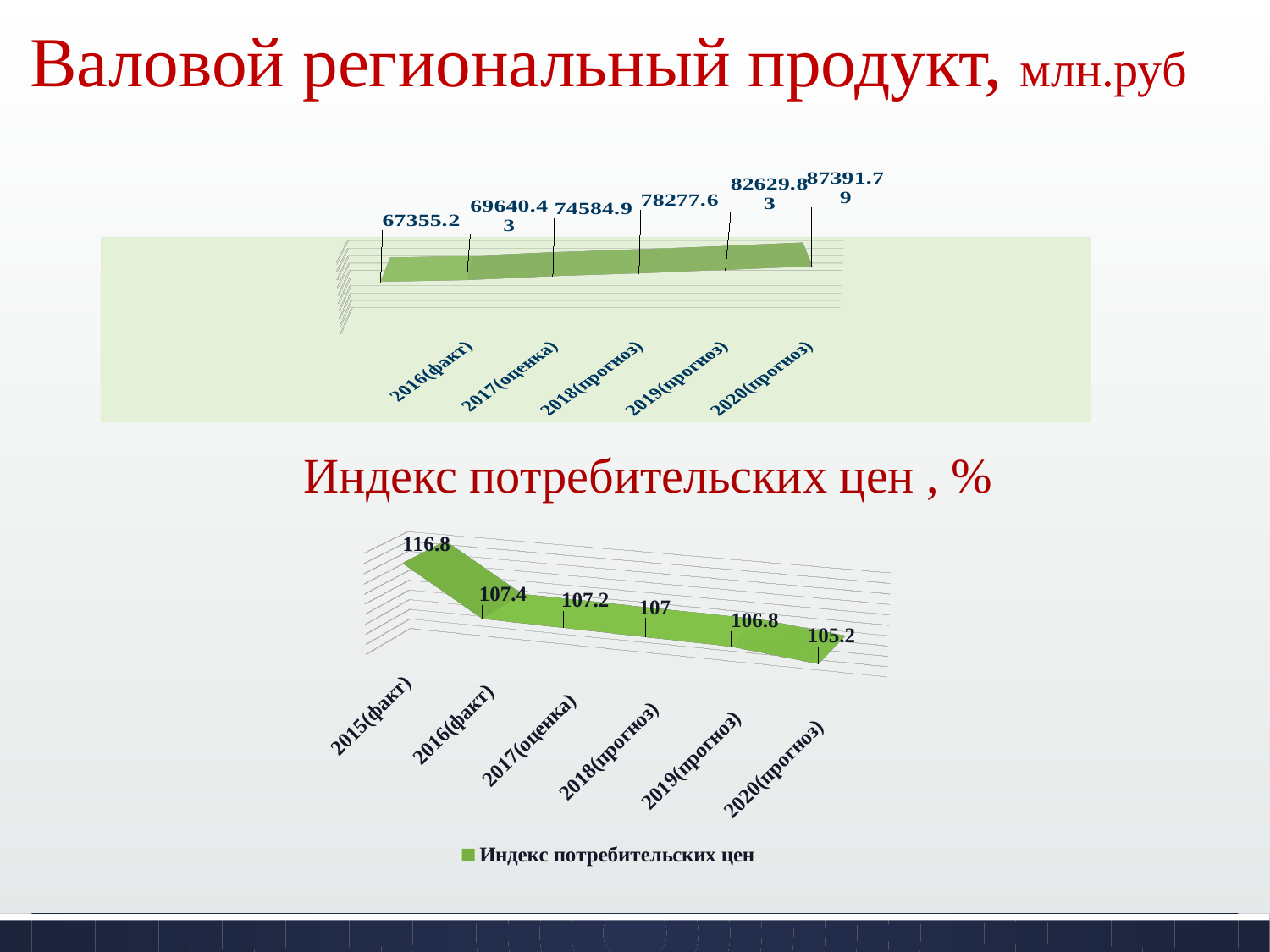
In the bottom chart (Индекс потребительских цен, %), which category has the highest value? 2015(факт) How many categories are shown on the x axis of the bottom chart (Индекс потребительских цен, %)? 6 In the bottom chart (Индекс потребительских цен, %), which category has the lowest value? 2020(прогноз) In the bottom chart (Индекс потребительских цен, %), what is the value for 2020(прогноз)? 105.2 Do the values in the top chart (Валовой региональный продукт, млн.руб) rise or fall from left to right along the x axis? rise In the bottom chart (Индекс потребительских цен, %), which is larger: the value for 2017(оценка) or 2019(прогноз)? 2017(оценка) Do the values in the bottom chart (Индекс потребительских цен, %) rise or fall from left to right along the x axis? fall In the bottom chart (Индекс потребительских цен, %), what is the value for 2015(факт)? 116.8 In the bottom chart (Индекс потребительских цен, %), what is the difference between the values for 2015(факт) and 2016(факт)? 9.4 How many series does the legend of the bottom chart (Индекс потребительских цен, %) list? 1 In the top chart (Валовой региональный продукт, млн.руб), what is the highest value shown? 87391.79 In the bottom chart (Индекс потребительских цен, %), what is the value for 2018(прогноз)? 107